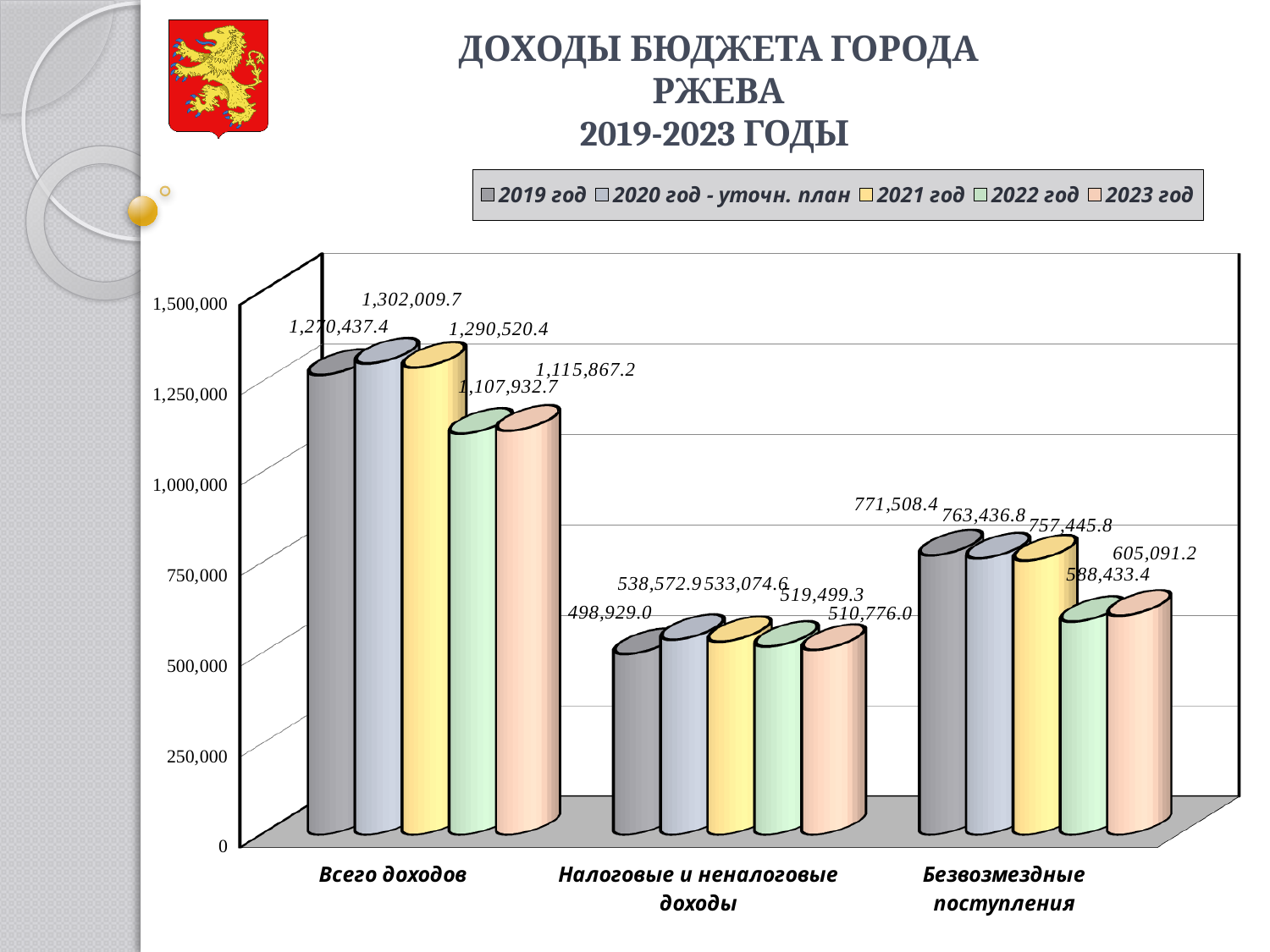
What is the title of the chart? ДОХОДЫ БЮДЖЕТА ГОРОДА РЖЕВА 2019-2023 ГОДЫ What type of chart is shown on the slide? bar chart What is the value for 'Налоговые и неналоговые доходы' in 2019 год? 498,929.0 Is the value for 'Безвозмездные поступления' in 2022 год greater or less than 750,000? less What is the value for 'Безвозмездные поступления' in 2023 год? 605,091.2 What is the value for 'Всего доходов' in 2020 год - уточн. план? 1,302,009.7 Which is larger for 'Налоговые и неналоговые доходы': the 2020 год - уточн. план value or the 2023 год value? 2020 год - уточн. план How many series does the legend list? 5 How many categories are shown on the x axis? 3 Which year has the lowest value for 'Всего доходов'? 2022 год What is the difference between the 2021 год and 2022 год values for 'Всего доходов'? 182,587.7 Which year has the highest value for 'Безвозмездные поступления'? 2019 год